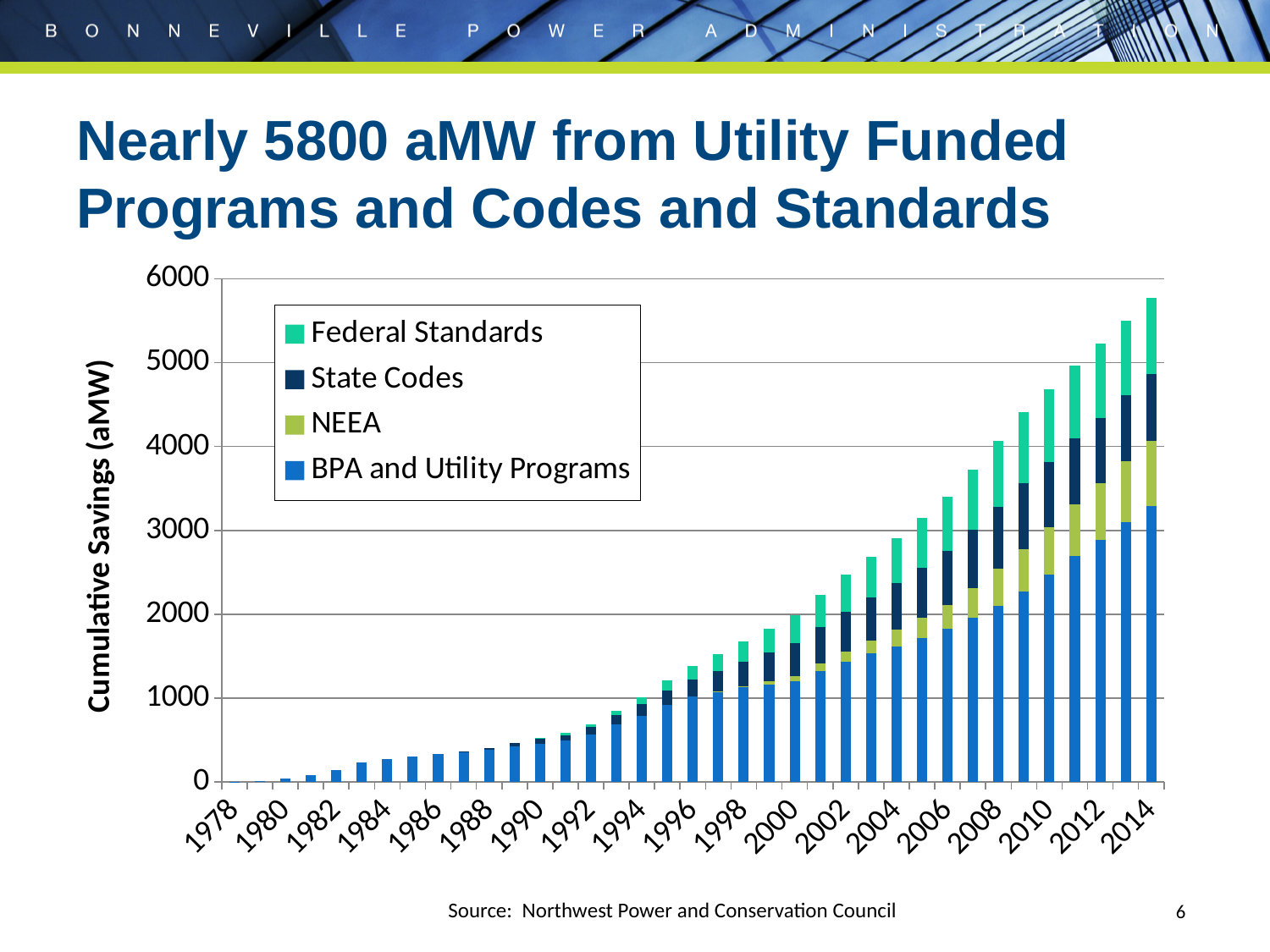
Do the total cumulative savings rise or fall from 1978 to 2014? Rise Which year has the lowest total cumulative savings? 1978 Is the total cumulative savings for 2002 greater or less than 2000? greater Which series is shown at the bottom of each stacked bar? BPA and Utility Programs Is the total cumulative savings for 2010 greater or less than 4000? greater What is the label on the vertical axis? Cumulative Savings (aMW) How many series does the legend list? 4 Is the total cumulative savings for 2014 greater or less than 5000? greater Which year has a larger total cumulative savings, 2006 or 1998? 2006 Which year has the highest total cumulative savings? 2014 What kind of chart is shown on the slide? Stacked bar chart